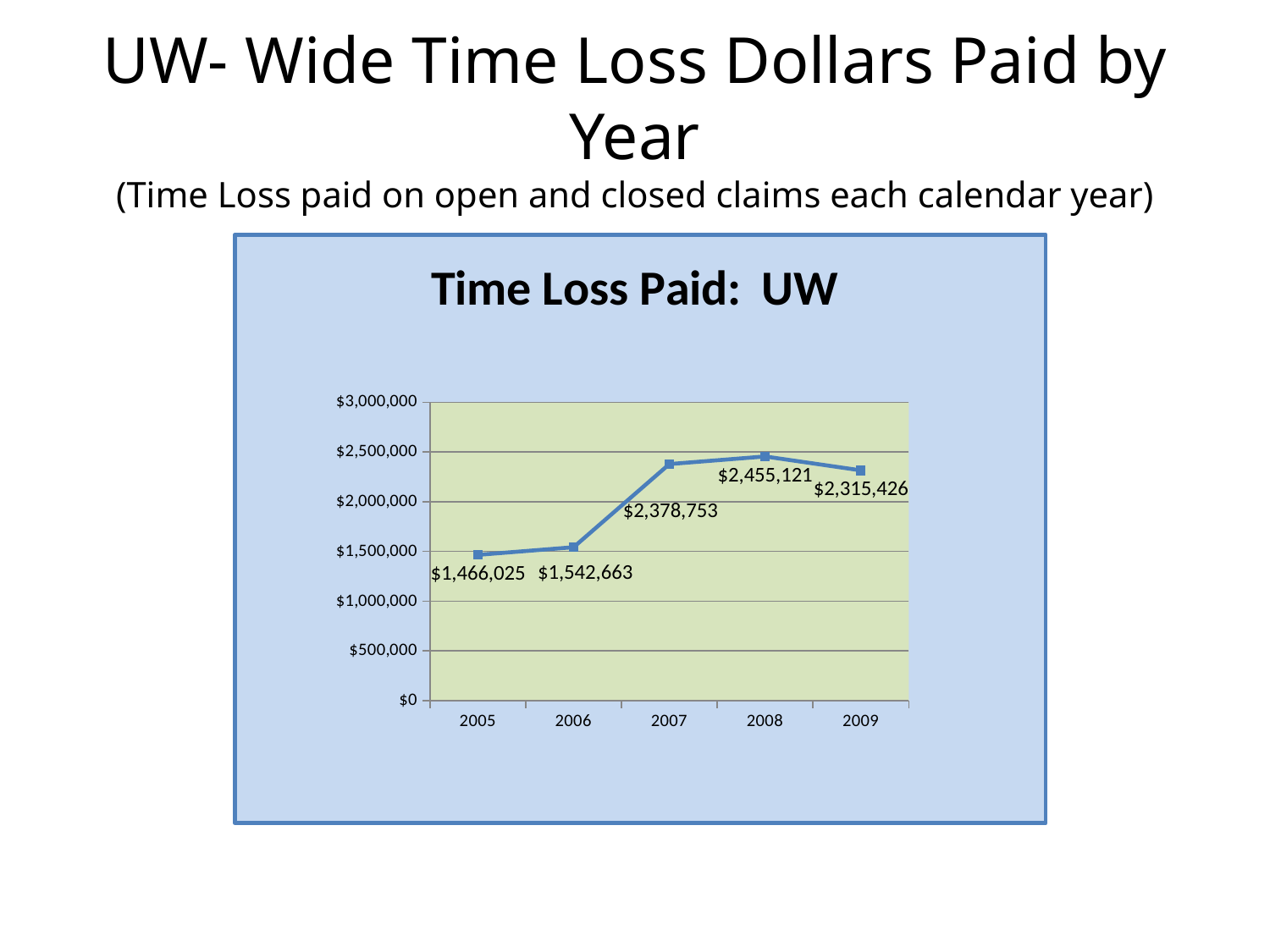
Is the time loss paid value for 2006 greater or less than $2,000,000? less What is the time loss paid value for 2005? $1,466,025 How many years are plotted on the chart? 5 Which year has the highest time loss paid? 2008 What is the difference between the time loss paid in 2008 and in 2009? $139,695 What is the time loss paid value for 2009? $2,315,426 What is the title of the chart? Time Loss Paid: UW What is the difference between the time loss paid in 2008 and in 2007? $76,368 Which year has a larger time loss paid value, 2006 or 2007? 2007 What type of chart is shown on the slide? line chart What is the time loss paid value for 2007? $2,378,753 Which year has the lowest time loss paid? 2005